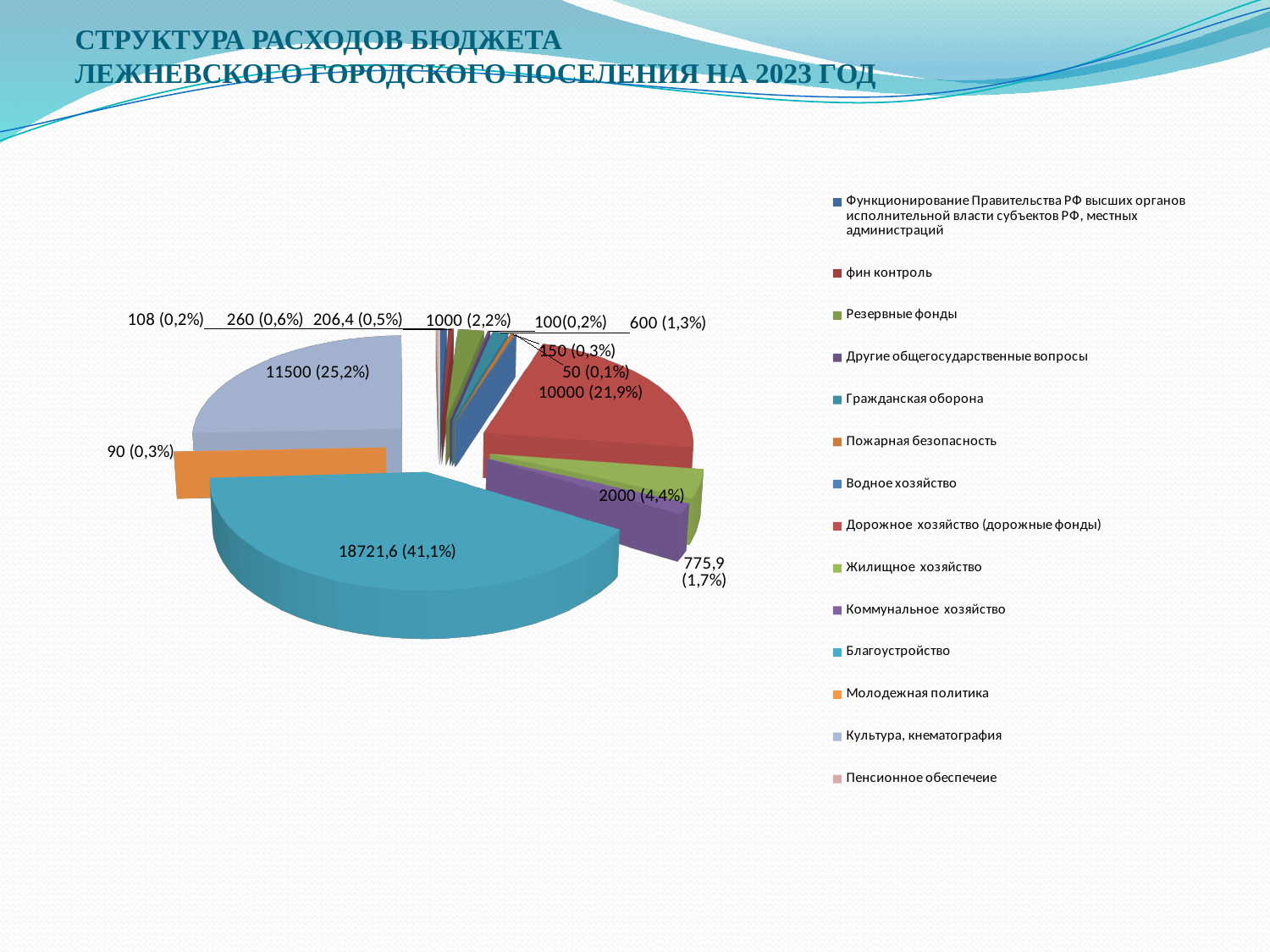
What value is shown for Коммунальное хозяйство? 775,9 What value is shown for Жилищное хозяйство? 2000 What value is shown for Дорожное хозяйство (дорожные фонды)? 10000 What share of the pie does Молодежная политика account for? 0,3% What share of the pie does Культура, кнематография account for? 25,2% What value is shown for Благоустройство in the pie chart? 18721,6 What kind of chart is shown on the slide? Pie chart Which category has the largest slice of the pie chart? Благоустройство What share of the pie does Благоустройство account for? 41,1% Which is larger: the value for Культура, кнематография or the value for Дорожное хозяйство (дорожные фонды)? Культура, кнематография How many entries does the legend of the pie chart list? 14 What is the difference between the values for Культура, кнематография (11500) and Дорожное хозяйство (10000)? 1500